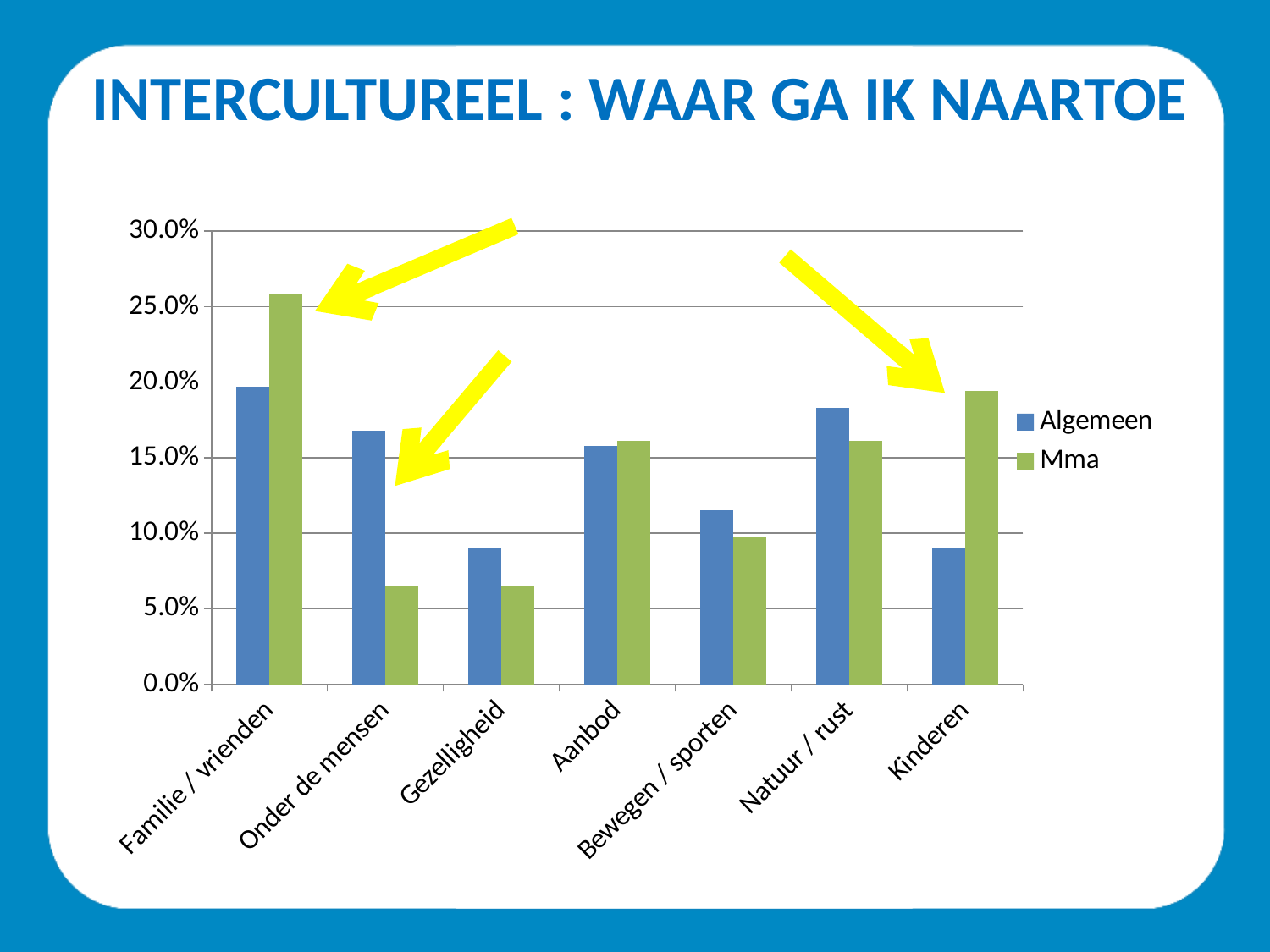
Is the Mma value for Familie / vrienden greater or less than 20.0%? greater What kind of chart is shown on the slide? bar chart Is the Mma value for Onder de mensen greater or less than 10.0%? less How many series does the chart's legend list? 2 Is the Algemeen value for Onder de mensen greater or less than 15.0%? greater How many categories are shown on the x axis of the chart? 7 Which category has the highest value for the Mma series? Familie / vrienden Which category has the highest value for the Algemeen series? Familie / vrienden What are the two series names listed in the chart's legend? Algemeen and Mma For Kinderen, which series has the larger value, Algemeen or Mma? Mma For Natuur / rust, which series has the larger value, Algemeen or Mma? Algemeen